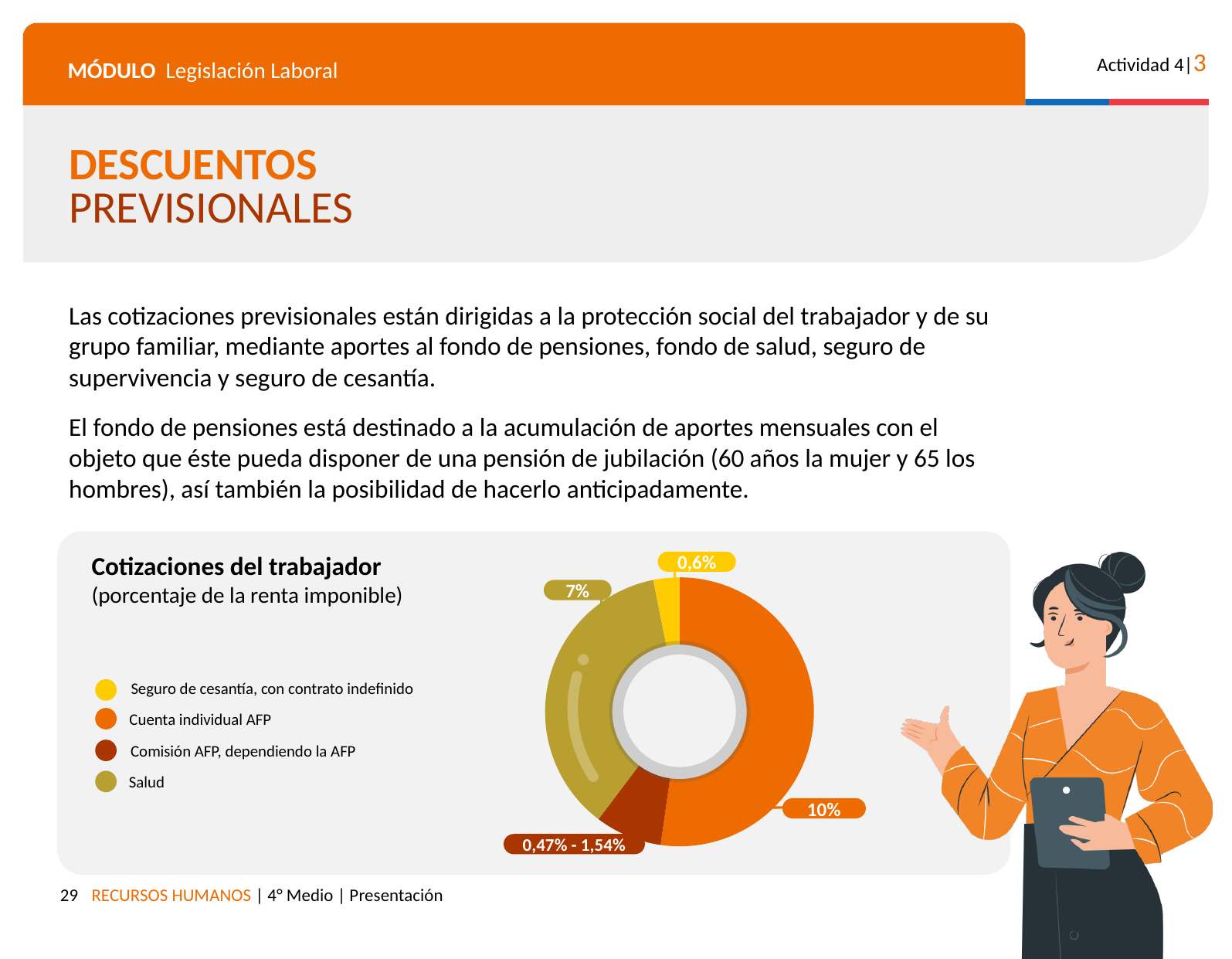
Which is larger, the percentage for Salud or for Seguro de cesantía, con contrato indefinido? Salud Which category has the lowest percentage? Seguro de cesantía, con contrato indefinido What percentage is shown for Salud? 7% Which colour represents Salud in the chart? Olive/gold Which category has the highest percentage? Cuenta individual AFP What is the title of the chart? Cotizaciones del trabajador (porcentaje de la renta imponible) What kind of chart is shown on the slide? Donut (pie) chart What percentage is shown for Cuenta individual AFP? 10% What percentage is shown for Seguro de cesantía, con contrato indefinido? 0,6% What range is shown for Comisión AFP, dependiendo la AFP? 0,47% - 1,54% How many categories does the chart legend list? 4 What is the difference between the percentages for Cuenta individual AFP and Salud? 3%